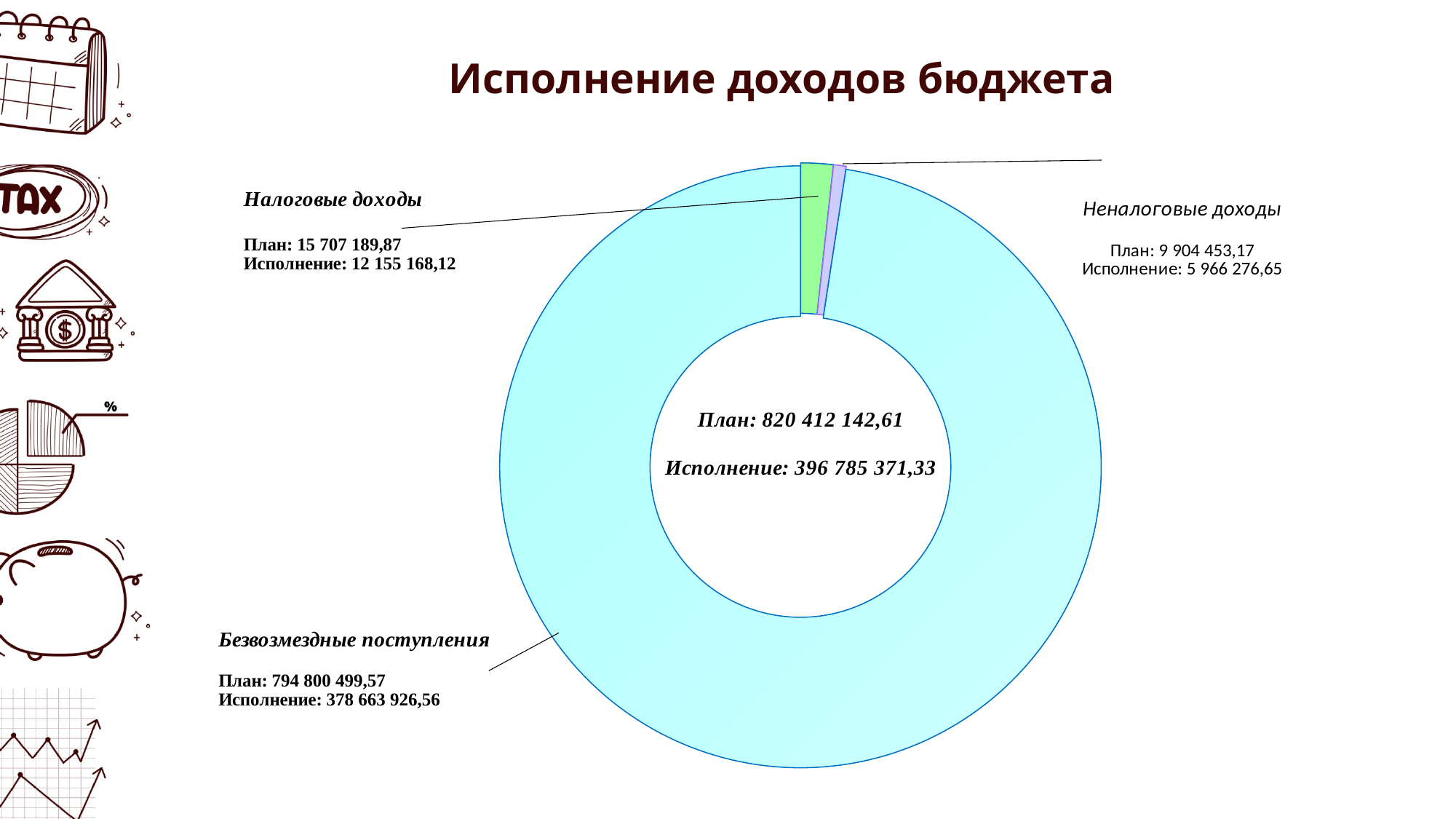
Which category has the largest slice of the chart? Безвозмездные поступления How many categories does the chart show? 3 What is the planned value (План) for Налоговые доходы? 15 707 189,87 What is the total planned value (План) across all three categories? 820 412 142,61 Which category has the smallest slice of the chart? Неналоговые доходы What colour is the slice for Налоговые доходы? green What is the planned value (План) for Безвозмездные поступления? 794 800 499,57 What is the executed value (Исполнение) for Неналоговые доходы? 5 966 276,65 What is the difference between the planned and executed values for Налоговые доходы? 3 552 021,75 Which has the larger executed value (Исполнение): Налоговые доходы or Неналоговые доходы? Налоговые доходы What kind of chart is shown on the slide? doughnut (pie) chart What is the total executed value (Исполнение) shown in the centre of the chart? 396 785 371,33